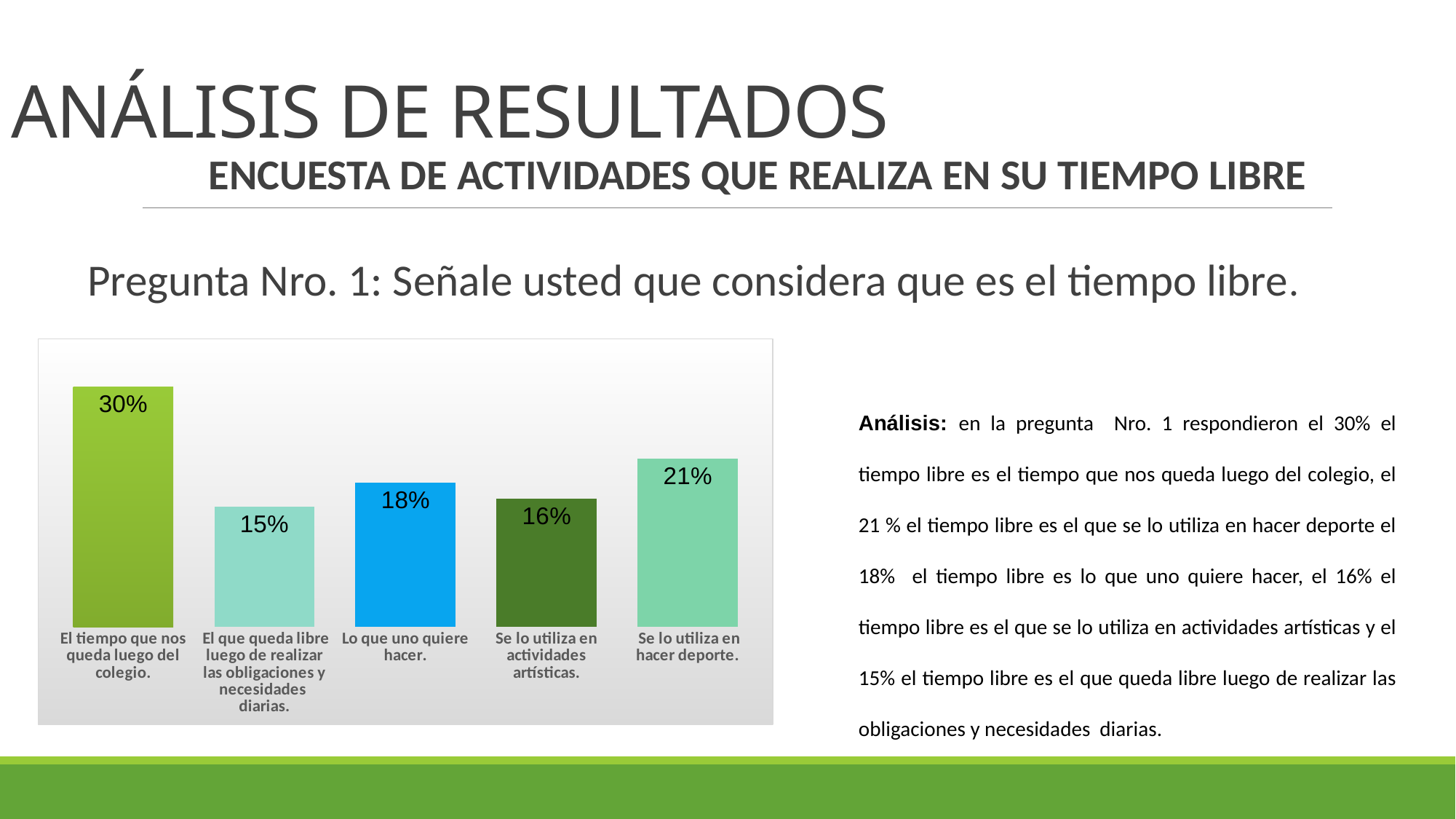
What value is shown for 'Lo que uno quiere hacer.'? 18% What percentage of respondents chose 'El tiempo que nos queda luego del colegio.'? 30% What value is shown for 'Se lo utiliza en hacer deporte.'? 21% What value is shown for 'Se lo utiliza en actividades artísticas.'? 16% Which category has the lowest value? El que queda libre luego de realizar las obligaciones y necesidades diarias. Which category has the highest value? El tiempo que nos queda luego del colegio. How many categories are shown in the chart? 5 Which is larger: the value for 'Lo que uno quiere hacer.' or for 'Se lo utiliza en actividades artísticas.'? Lo que uno quiere hacer. What colour is the bar for 'Lo que uno quiere hacer.'? Blue What is the difference between the values for 'El tiempo que nos queda luego del colegio.' and 'Se lo utiliza en hacer deporte.'? 9% What is the difference between the values for 'Lo que uno quiere hacer.' and 'El que queda libre luego de realizar las obligaciones y necesidades diarias.'? 3% What kind of chart is shown on the slide? Bar chart